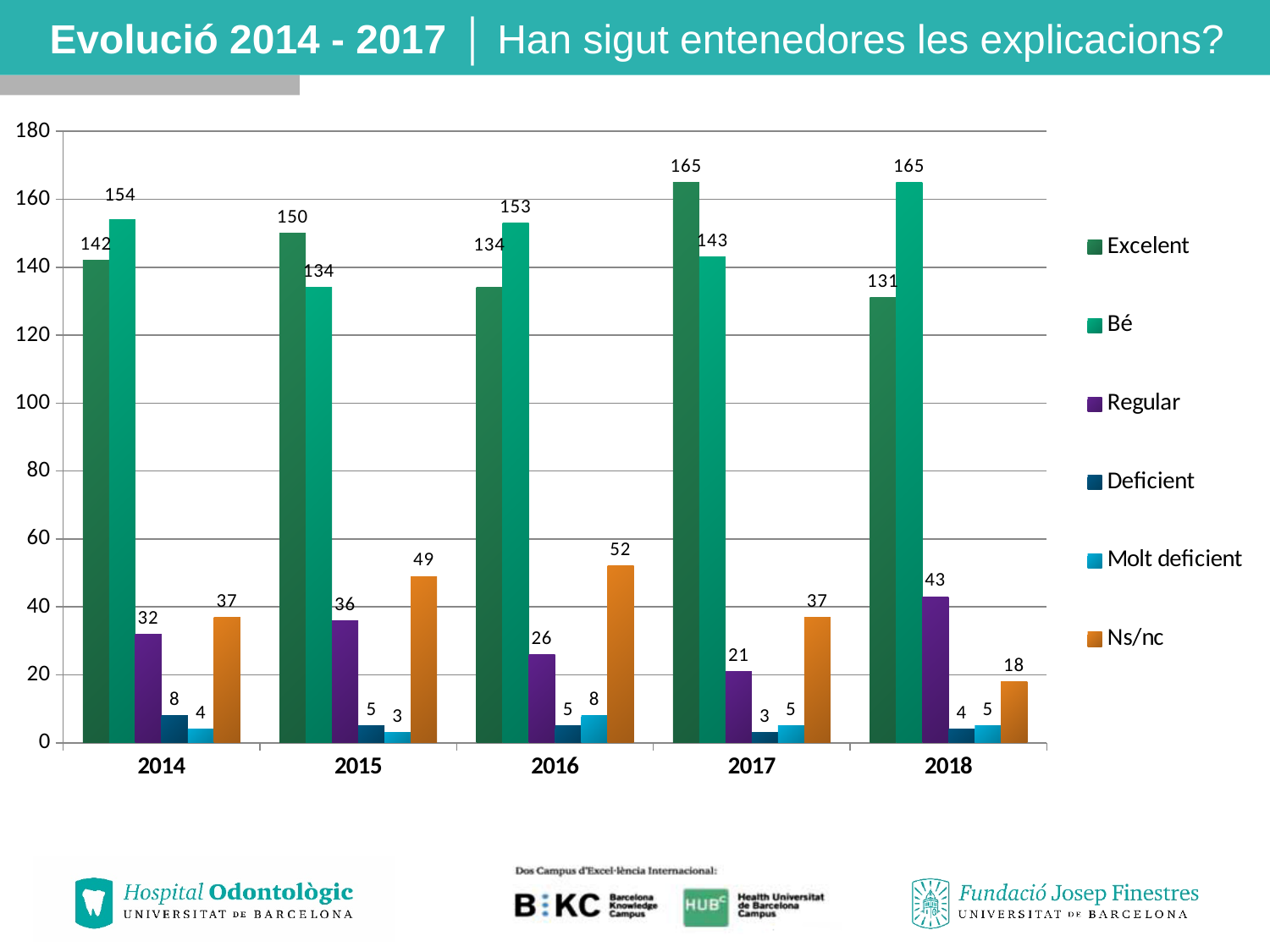
Which series is shown in orange in the legend? Ns/nc What kind of chart is shown on the slide? Bar chart What is the value for Regular in 2018? 43 What is the value for Ns/nc in 2016? 52 What is the difference between the Bé and Excelent values in 2018? 34 How many series does the legend list? 6 In which year is the Ns/nc value lowest? 2018 Which is larger in 2014, Excelent or Bé? Bé How many years are shown on the x axis? 5 What is the value for Excelent in 2017? 165 In which year is the Excelent value highest? 2017 What is the value for Bé in 2015? 134